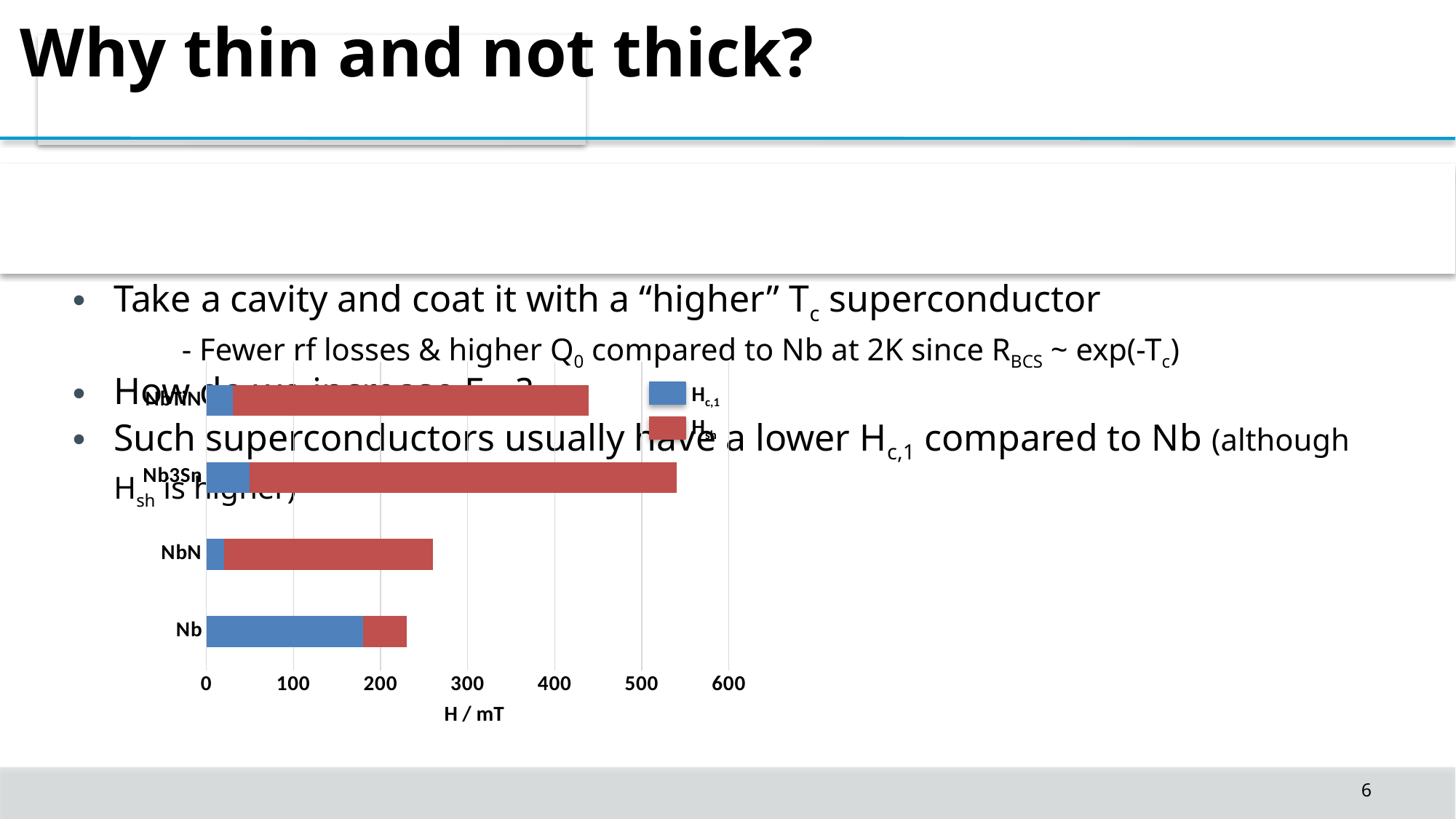
Is the H_c,1 value for Nb3Sn greater or less than 100? less Is the total bar length for NbN greater or less than 300? less Which material has the longest total bar in the chart? Nb3Sn Which has the longer total bar, Nb3Sn or NbN? Nb3Sn Which material has the largest H_c,1 (blue) segment? Nb What is the title of the horizontal axis of the chart? H / mT What kind of chart is shown on the slide? bar chart How many series does the chart legend list? 2 How many materials (categories) are plotted in the chart? 4 Is the H_c,1 value for Nb greater or less than 100? greater Which colour represents H_sh in the chart legend? red